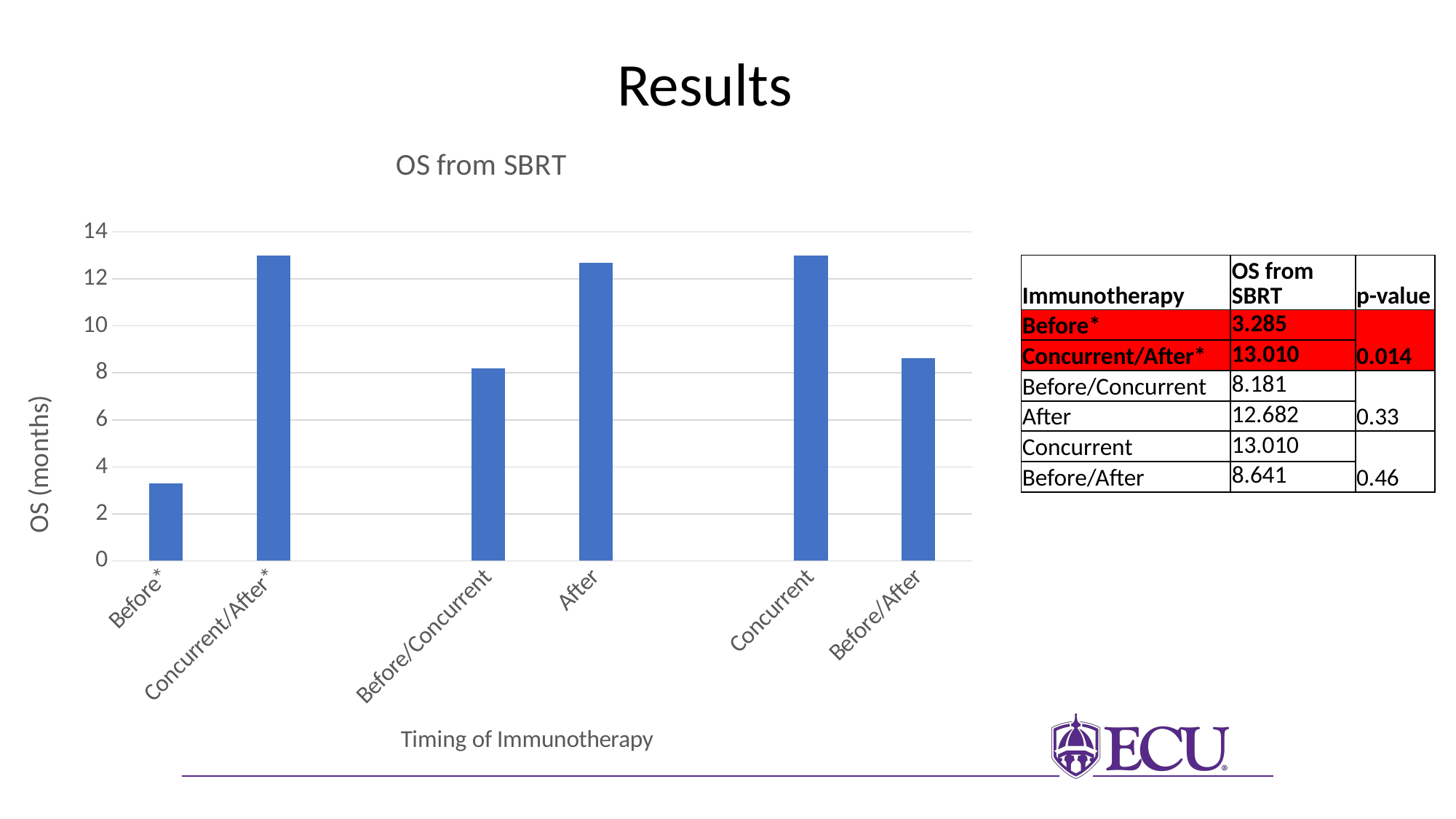
Which category has the lowest OS from SBRT on the chart? Before* Is the value for Before/After greater or less than 10? less How many categories are plotted on the chart? 6 What type of chart is shown on the slide? bar chart What is the label of the x axis of the chart? Timing of Immunotherapy What is the title of the chart? OS from SBRT According to the slide, what is the OS from SBRT value for Before*? 3.285 Which is larger on the chart, the value for Concurrent or the value for Before/After? Concurrent Which is larger on the chart, the value for After or the value for Before/Concurrent? After Is the value for Before* greater or less than 4? less Is the value for After greater or less than 12? greater According to the slide, what is the OS from SBRT value for After? 12.682